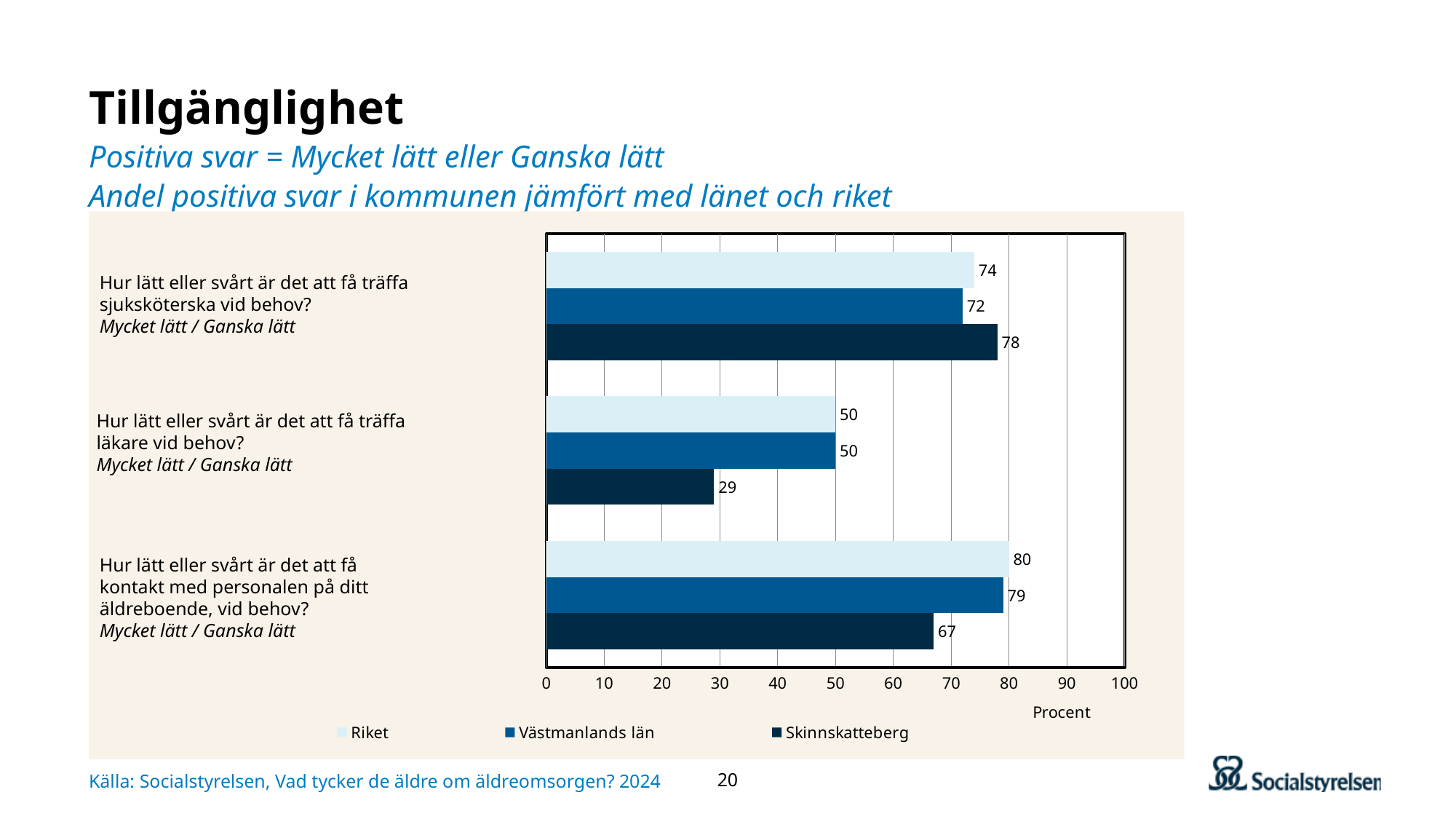
What is the value for Västmanlands län on the question about getting in contact with staff at the care home (personalen på ditt äldreboende)? 79 How many questions (categories) are shown on the chart? 3 What is the value for Skinnskatteberg on the question about meeting a nurse when needed (sjuksköterska)? 78 What kind of chart is shown on the slide? Bar chart Which is larger: the Riket value or the Västmanlands län value on the question about meeting a nurse when needed (sjuksköterska)? Riket What unit label is shown under the x axis of the chart? Procent Which series has the highest value on the question about meeting a nurse when needed (sjuksköterska)? Skinnskatteberg Which series has the lowest value on the question about meeting a doctor when needed (läkare)? Skinnskatteberg How many series does the legend list? 3 What is the difference between Riket and Skinnskatteberg on the question about getting in contact with staff at the care home? 13 What is the difference between Västmanlands län and Skinnskatteberg on the question about meeting a doctor when needed (läkare)? 21 What is the value for Riket on the question about meeting a doctor when needed (läkare)? 50